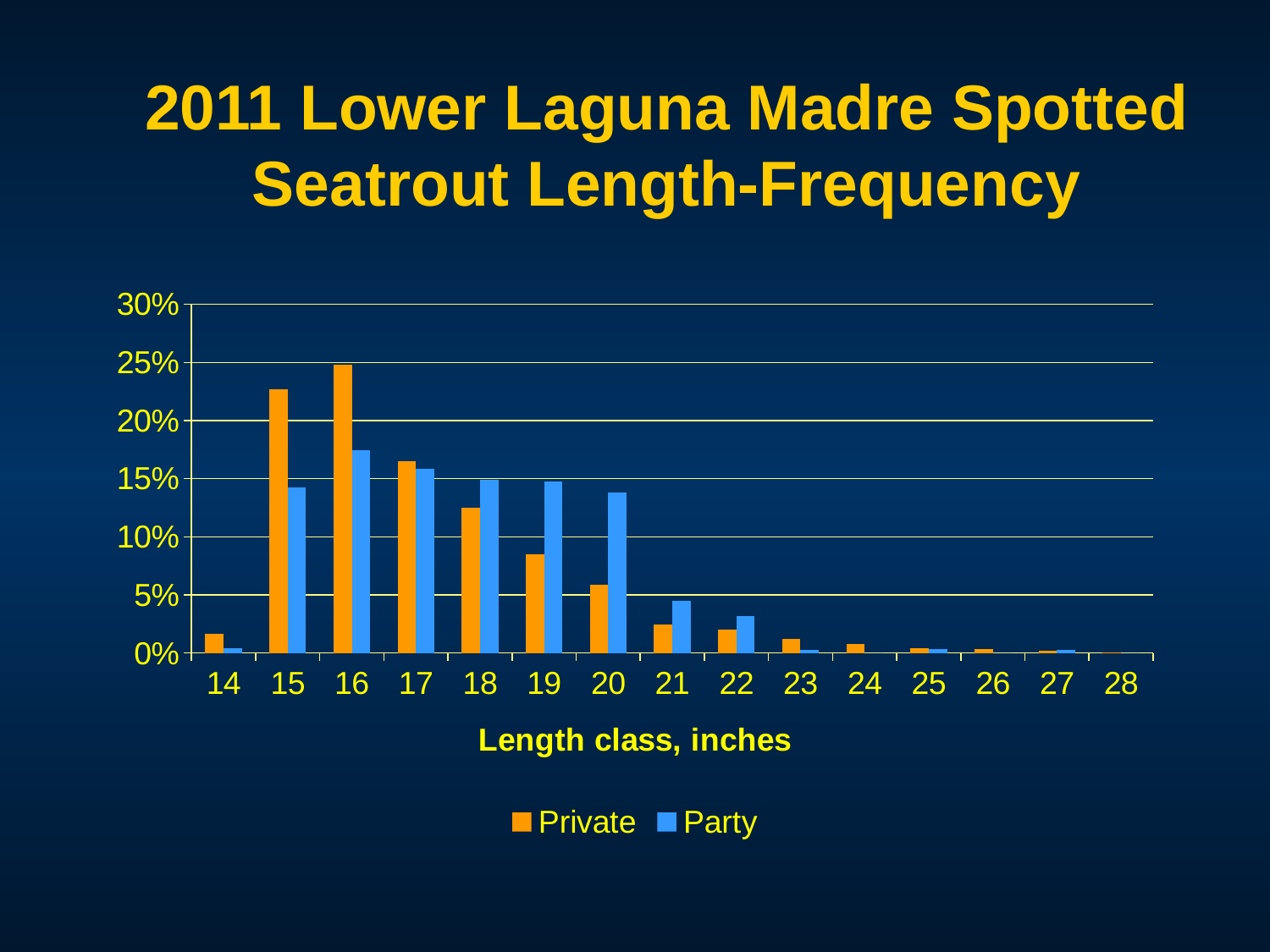
Is the Private value for length class 20 greater or less than 10%? less At length class 15, which series has the larger value, Private or Party? Private How many series does the legend list? 2 How many length classes are shown on the x axis? 15 Which length class has the highest Party value? 16 Is the Party value for length class 19 greater or less than 10%? greater What kind of chart is shown on the slide? bar chart Is the Private value for length class 16 greater or less than 20%? greater Which length class has the highest Private value? 16 At length class 19, which series has the larger value, Private or Party? Party Do the Private values rise or fall from length class 16 to length class 28? fall